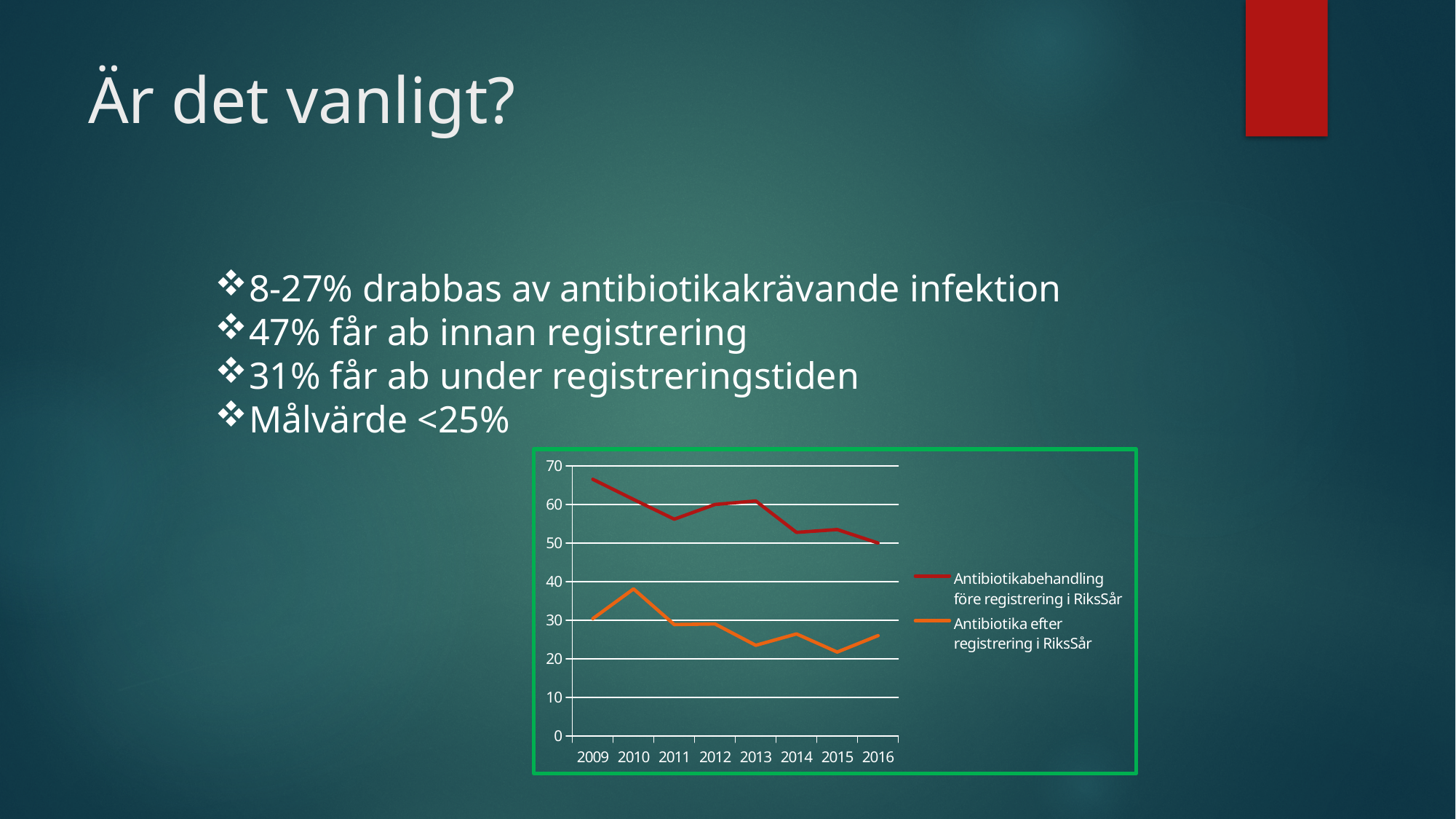
Is the value for 'Antibiotika efter registrering i RiksSår' in 2010 greater or less than 40? less Which year has the highest value for 'Antibiotika efter registrering i RiksSår'? 2010 Which year has the highest value for 'Antibiotikabehandling före registrering i RiksSår'? 2009 Which year has the lowest value for 'Antibiotikabehandling före registrering i RiksSår'? 2016 How many series does the chart's legend list? 2 Is the value for 'Antibiotikabehandling före registrering i RiksSår' in 2009 greater or less than 60? greater How many years are shown on the x axis of the chart? 8 What kind of chart is shown on the slide? line chart Which series has the larger value in 2009, 'Antibiotikabehandling före registrering i RiksSår' or 'Antibiotika efter registrering i RiksSår'? Antibiotikabehandling före registrering i RiksSår Overall, does the 'Antibiotikabehandling före registrering i RiksSår' line rise or fall from 2009 to 2016? fall What colour is the line for 'Antibiotika efter registrering i RiksSår'? orange Is the value for 'Antibiotika efter registrering i RiksSår' in 2015 greater or less than 30? less